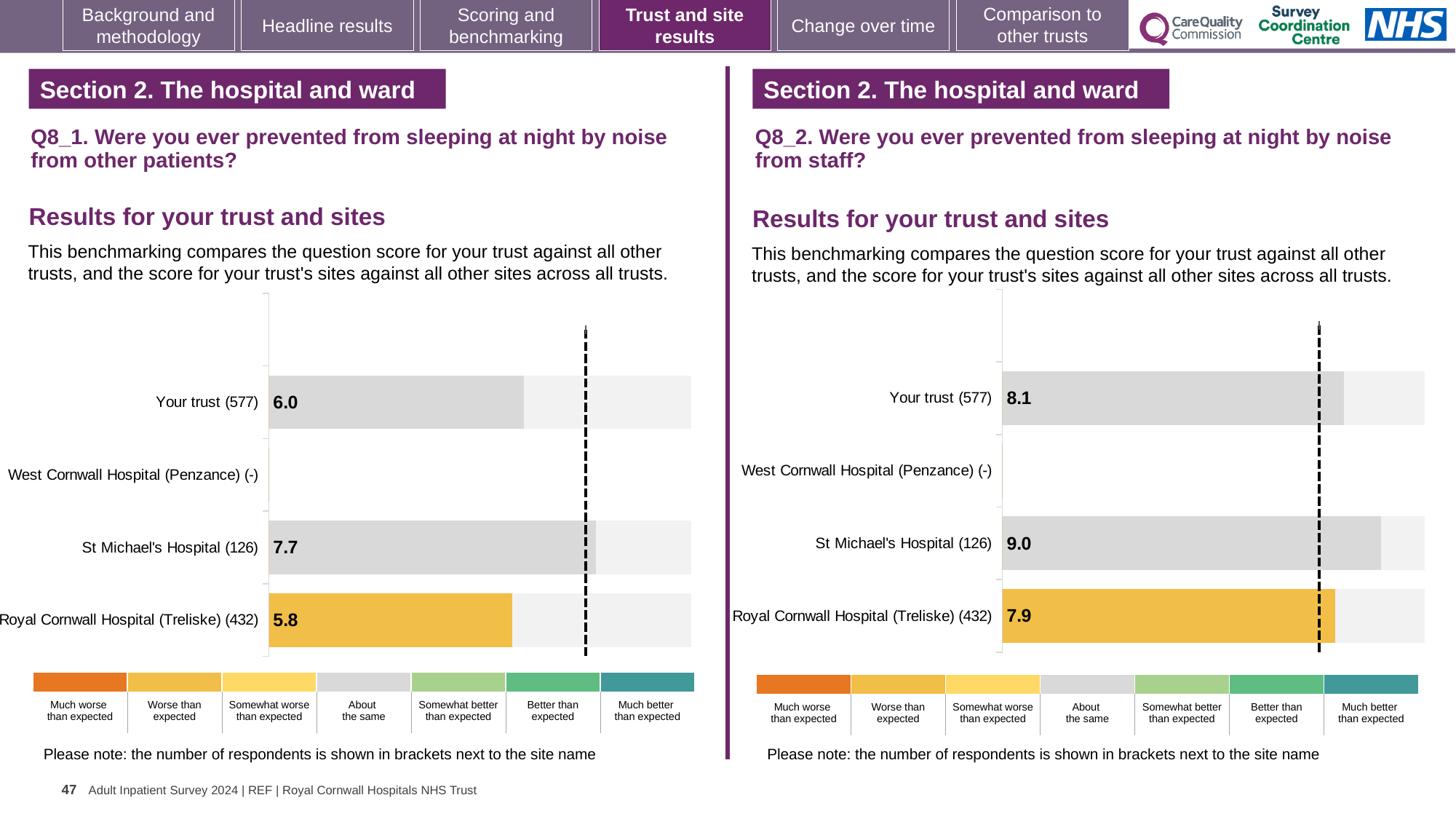
What kind of chart is used on the Q8_2 chart (noise from staff)? Bar chart On the Q8_1 chart (noise from other patients), which site or trust row has the highest score? St Michael's Hospital (126) On the Q8_2 chart (noise from staff), which has the higher score: Your trust or St Michael's Hospital? St Michael's Hospital On the Q8_2 chart (noise from staff), what is the score for Your trust (577)? 8.1 On the Q8_2 chart (noise from staff), what is the score for St Michael's Hospital (126)? 9.0 How many rows (trust and sites) are listed on the Q8_1 chart (noise from other patients)? 4 On the Q8_1 chart (noise from other patients), what is the score for Royal Cornwall Hospital (Treliske) (432)? 5.8 On the Q8_1 chart (noise from other patients), what is the score for Your trust (577)? 6.0 On the Q8_1 chart (noise from other patients), what is the difference between the scores for St Michael's Hospital and Royal Cornwall Hospital (Treliske)? 1.9 On the Q8_2 chart (noise from staff), which site or trust row has the lowest score? Royal Cornwall Hospital (Treliske) (432) On the Q8_2 chart (noise from staff), what is the score for Royal Cornwall Hospital (Treliske) (432)? 7.9 On the Q8_1 chart (noise from other patients), what is the score for St Michael's Hospital (126)? 7.7